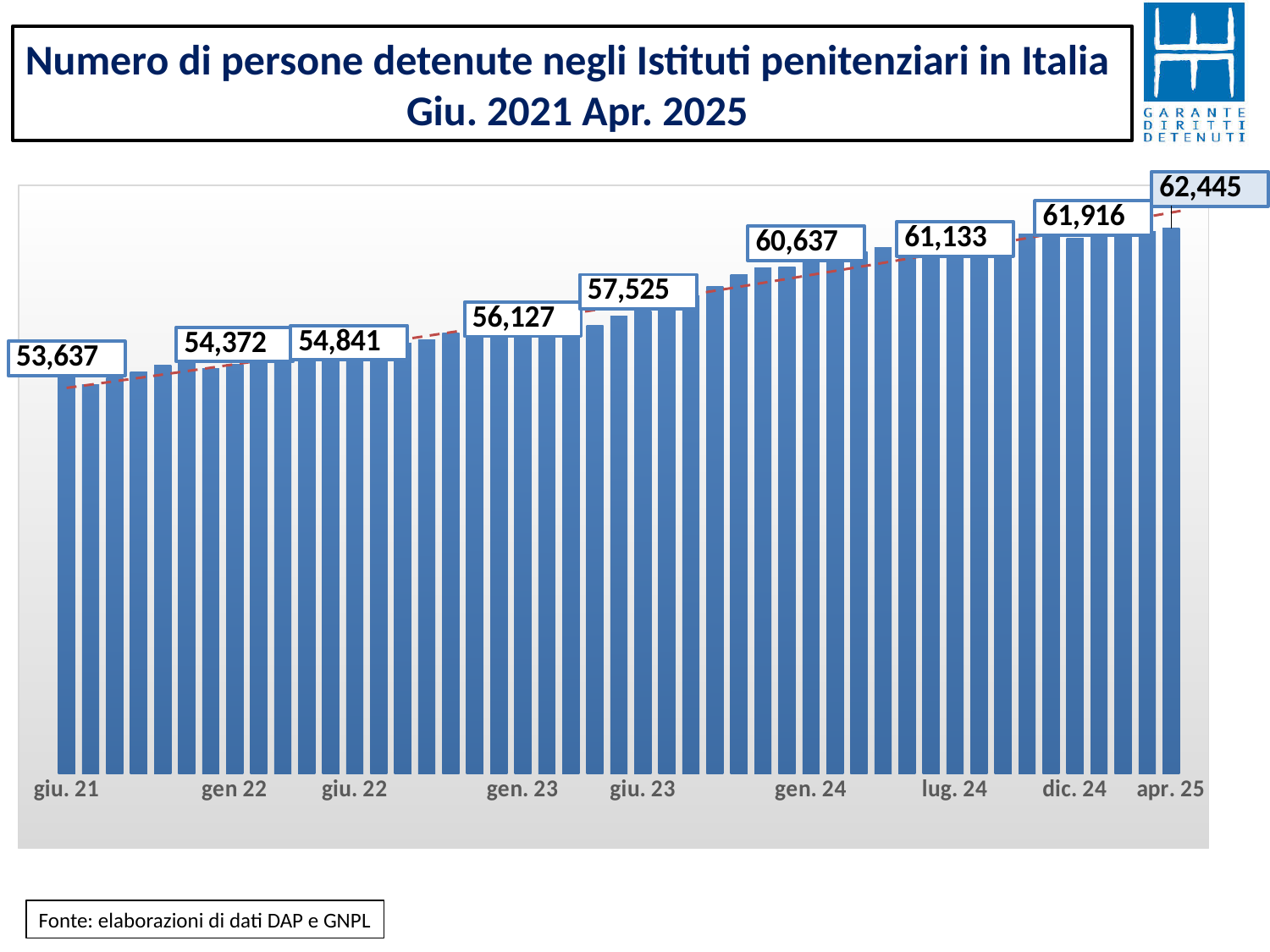
What value is labelled for gen 22? 54,372 What value is labelled for giu. 22? 54,841 What is the difference between the values for gen. 24 and giu. 23? 3,112 What value is labelled for apr. 25? 62,445 What value is labelled for gen. 23? 56,127 What is the number of detained persons shown for giu. 21? 53,637 What value is labelled for gen. 24? 60,637 Which is larger, the value for dic. 24 or the value for lug. 24? dic. 24 Which labelled period has the lowest value? giu. 21 What is the difference between the values for apr. 25 and giu. 21? 8,808 Do the values generally rise or fall from giu. 21 to apr. 25? rise Which labelled period has the highest value? apr. 25